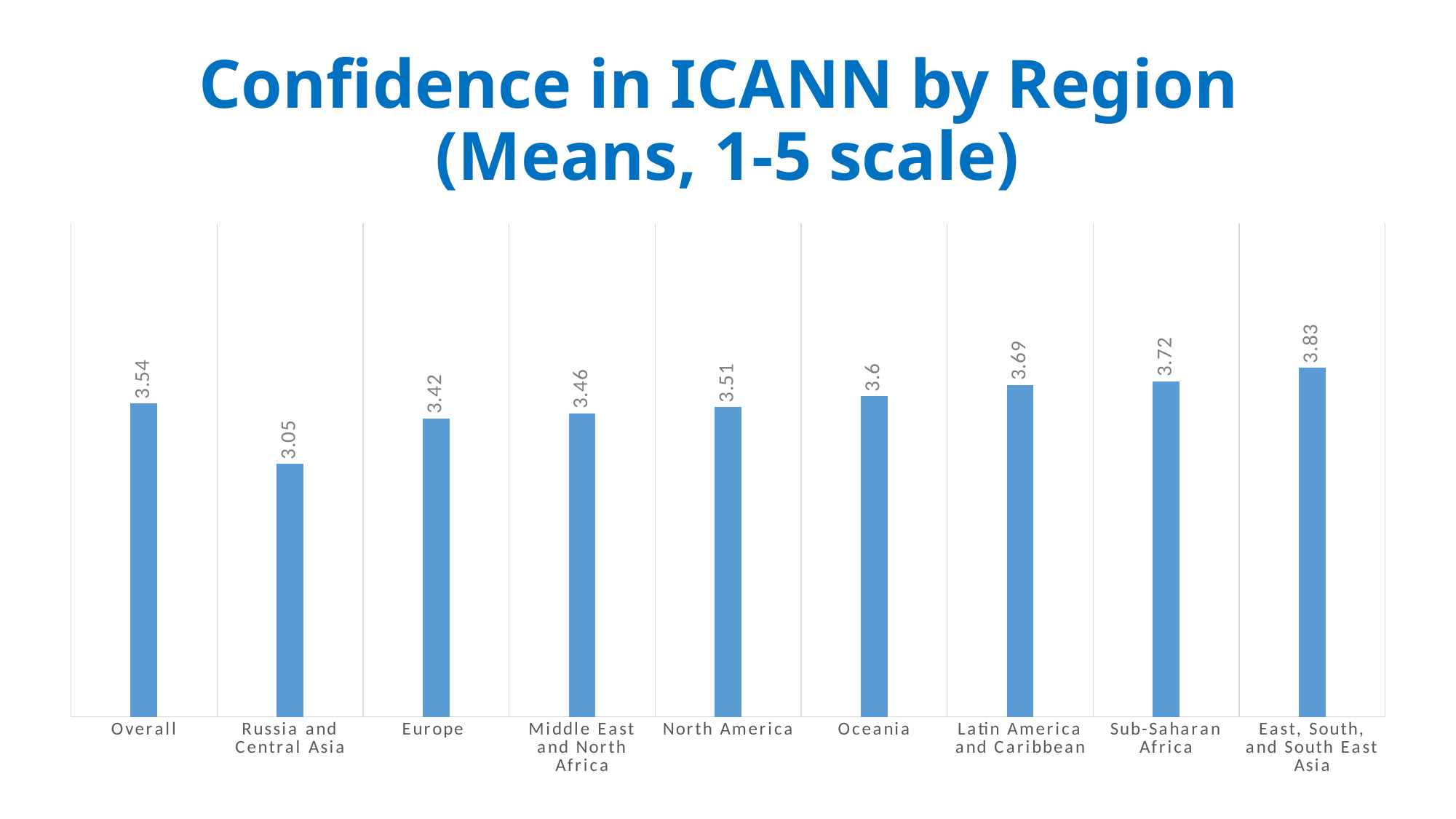
What is the difference between the mean for East, South, and South East Asia and the mean for Russia and Central Asia? 0.78 What is the mean confidence value for Europe? 3.42 What is the title of the chart? Confidence in ICANN by Region (Means, 1-5 scale) What is the Overall mean confidence value? 3.54 Which region has the lowest mean confidence in ICANN? Russia and Central Asia What is the mean confidence value for Sub-Saharan Africa? 3.72 How many categories are shown on the x axis of the chart? 9 Which region has the highest mean confidence in ICANN? East, South, and South East Asia Which has a higher mean confidence value, Latin America and Caribbean or Middle East and North Africa? Latin America and Caribbean What is the mean confidence value for Russia and Central Asia? 3.05 What kind of chart is shown on the slide? Bar chart What is the difference between the mean for Oceania and the mean for North America? 0.09